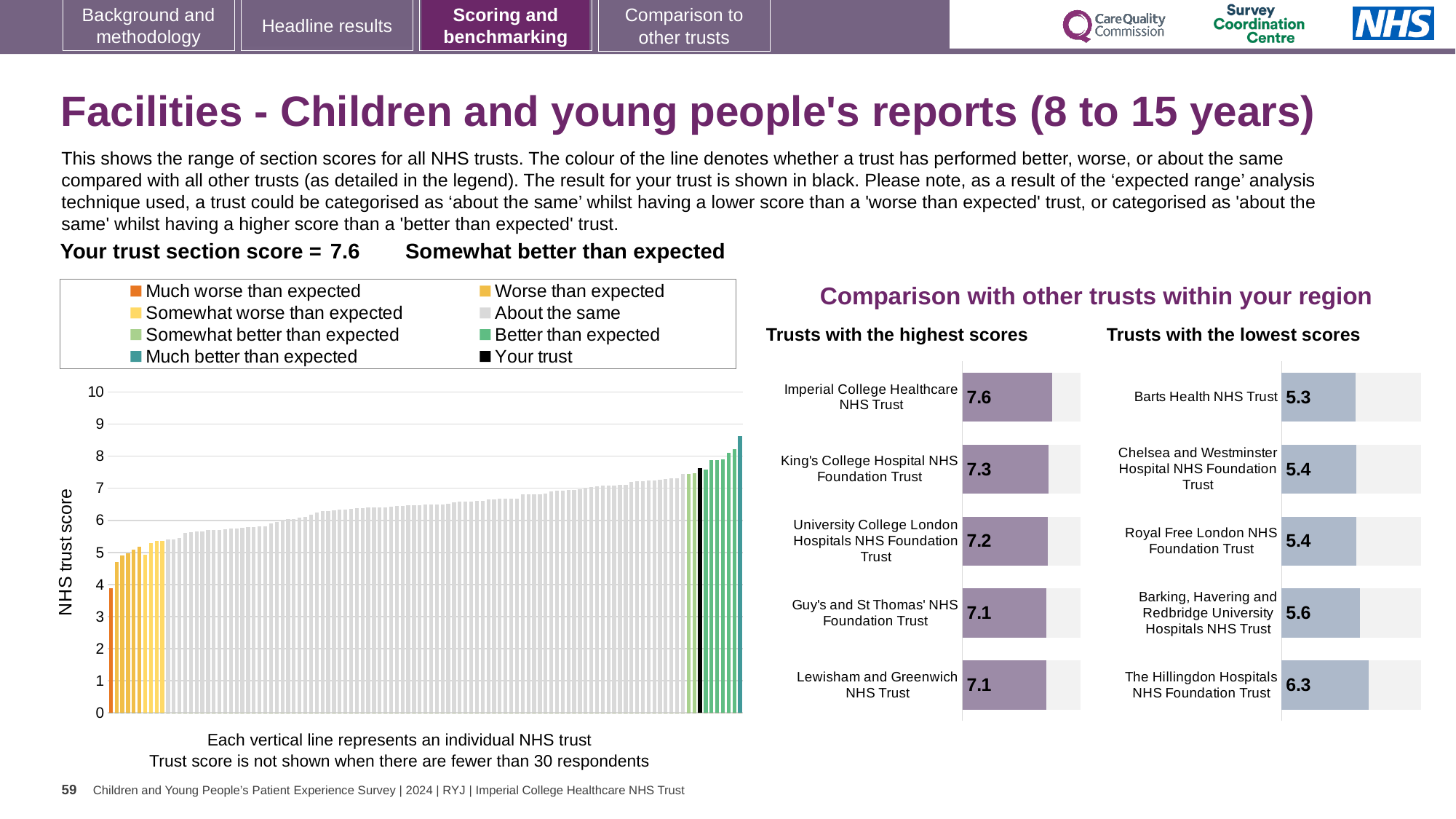
In the large 'NHS trust score' chart on the left, is the value for the black 'Your trust' bar greater or less than 7? greater In the 'Trusts with the lowest scores' chart, what is the difference between the scores of The Hillingdon Hospitals NHS Foundation Trust and Barts Health NHS Trust? 1.0 What kind of chart is the large 'NHS trust score' chart on the left? bar chart In the 'Trusts with the highest scores' chart, what is the score for King's College Hospital NHS Foundation Trust? 7.3 In the large 'NHS trust score' chart on the left, do the bar values rise or fall from left to right? rise In the 'Trusts with the highest scores' chart, which trust has the highest score? Imperial College Healthcare NHS Trust In the 'Trusts with the lowest scores' chart, which trust has the lowest score? Barts Health NHS Trust In the 'Trusts with the highest scores' chart, what is the difference between the scores of Imperial College Healthcare NHS Trust and King's College Hospital NHS Foundation Trust? 0.3 In the 'Trusts with the lowest scores' chart, what is the score for The Hillingdon Hospitals NHS Foundation Trust? 6.3 How many trusts are shown in the 'Trusts with the highest scores' chart? 5 How many entries does the legend above the large 'NHS trust score' chart list? 8 In the 'Trusts with the lowest scores' chart, which has the larger score: Barking, Havering and Redbridge University Hospitals NHS Trust or Barts Health NHS Trust? Barking, Havering and Redbridge University Hospitals NHS Trust